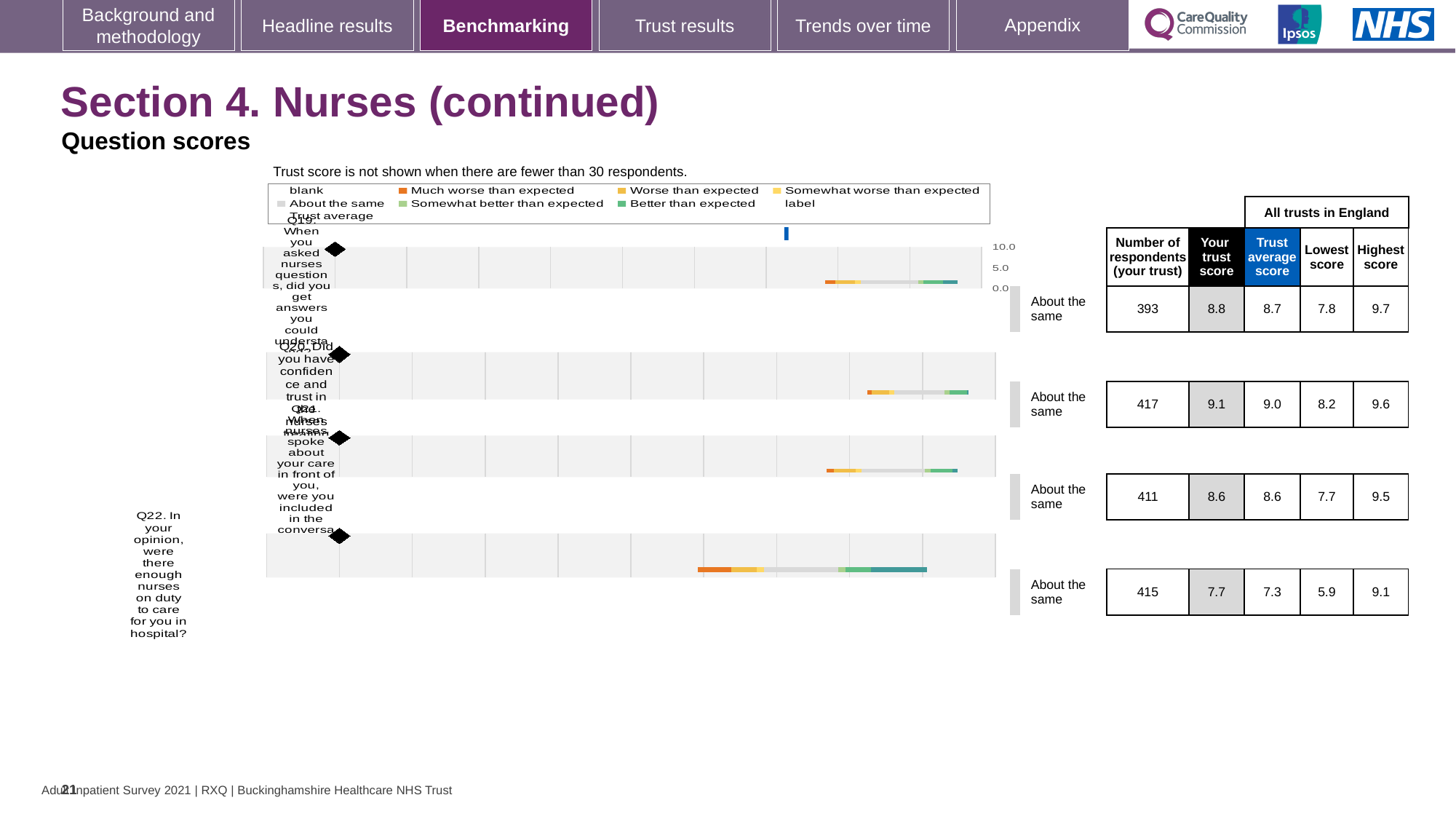
Which question has the highest trust score? Q20 What is the trust average score for Q22? 7.3 What kind of chart is shown on the slide? bar chart What colour does the legend use for "Much worse than expected"? orange What is the highest score across all trusts in England for Q20? 9.6 What is the trust score for Q19? 8.8 What is the number of respondents for Q22? 415 Which question has the lowest trust score? Q22 For Q19, which is larger: the trust score or the trust average score? the trust score What is the difference between the trust score and the trust average score for Q22? 0.4 What is the highest value shown on the chart's score axis? 10.0 How many questions (categories) are plotted in the chart? 4